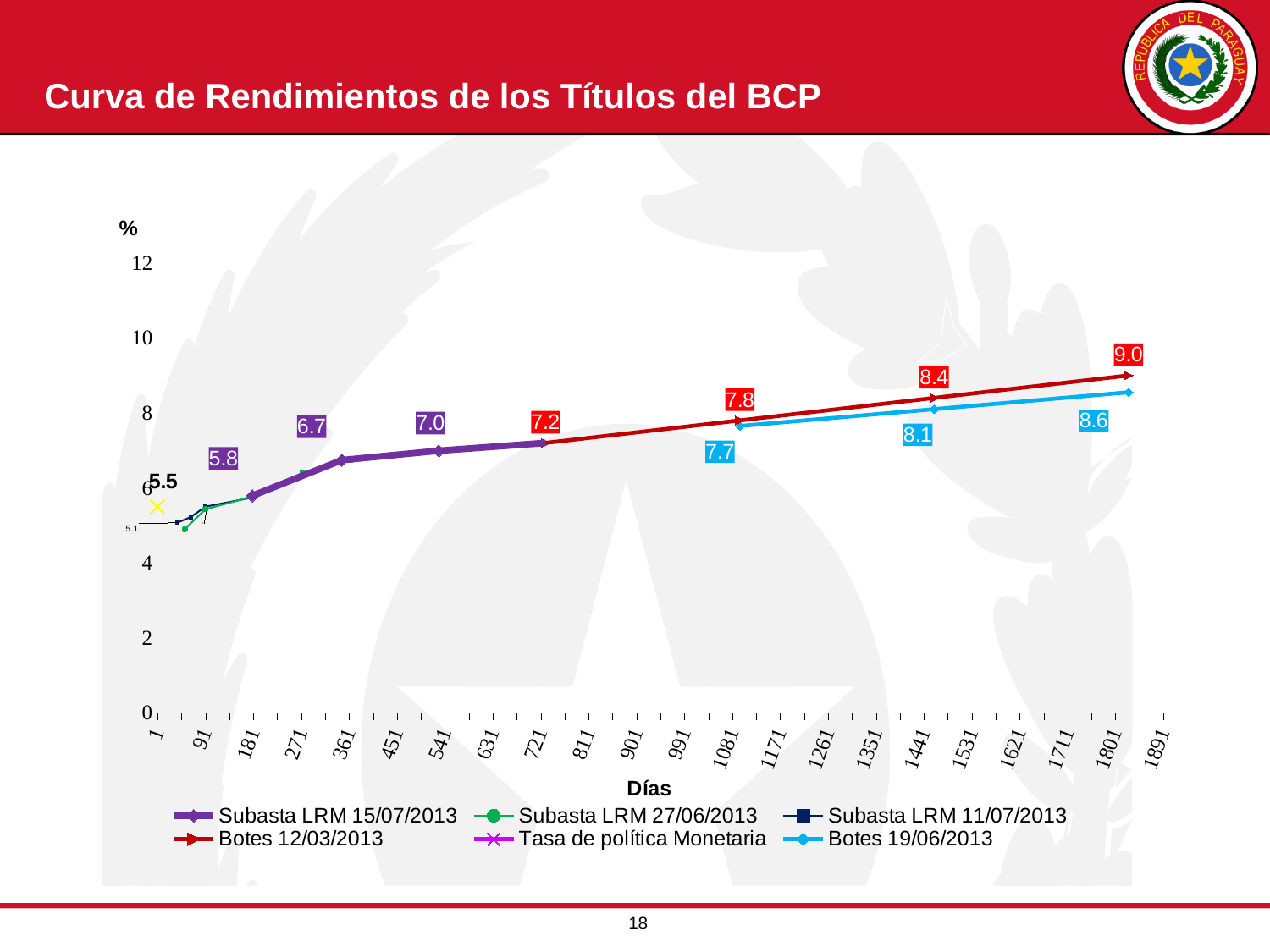
What type of chart is shown on the slide? Line chart Which series has the highest labelled value on the chart? Botes 12/03/2013 What is the difference between the final labelled values of Botes 12/03/2013 (9.0) and Botes 19/06/2013 (8.6)? 0.4 What is the difference between the last (7.2) and first (5.8) labelled values of the Subasta LRM 15/07/2013 series? 1.4 What is the first labelled value of the Subasta LRM 15/07/2013 series? 5.8 What is the last labelled value for the Botes 19/06/2013 series? 8.6 What is the labelled value for the Tasa de política Monetaria series? 5.5 What is the title of the x axis? Días Which is larger at around 1081 days: the Botes 12/03/2013 value (7.8) or the Botes 19/06/2013 value (7.7)? Botes 12/03/2013 What is the highest labelled value for the Botes 12/03/2013 series? 9.0 Does the Subasta LRM 15/07/2013 series rise or fall as the number of days increases? Rises How many series does the legend list? 6